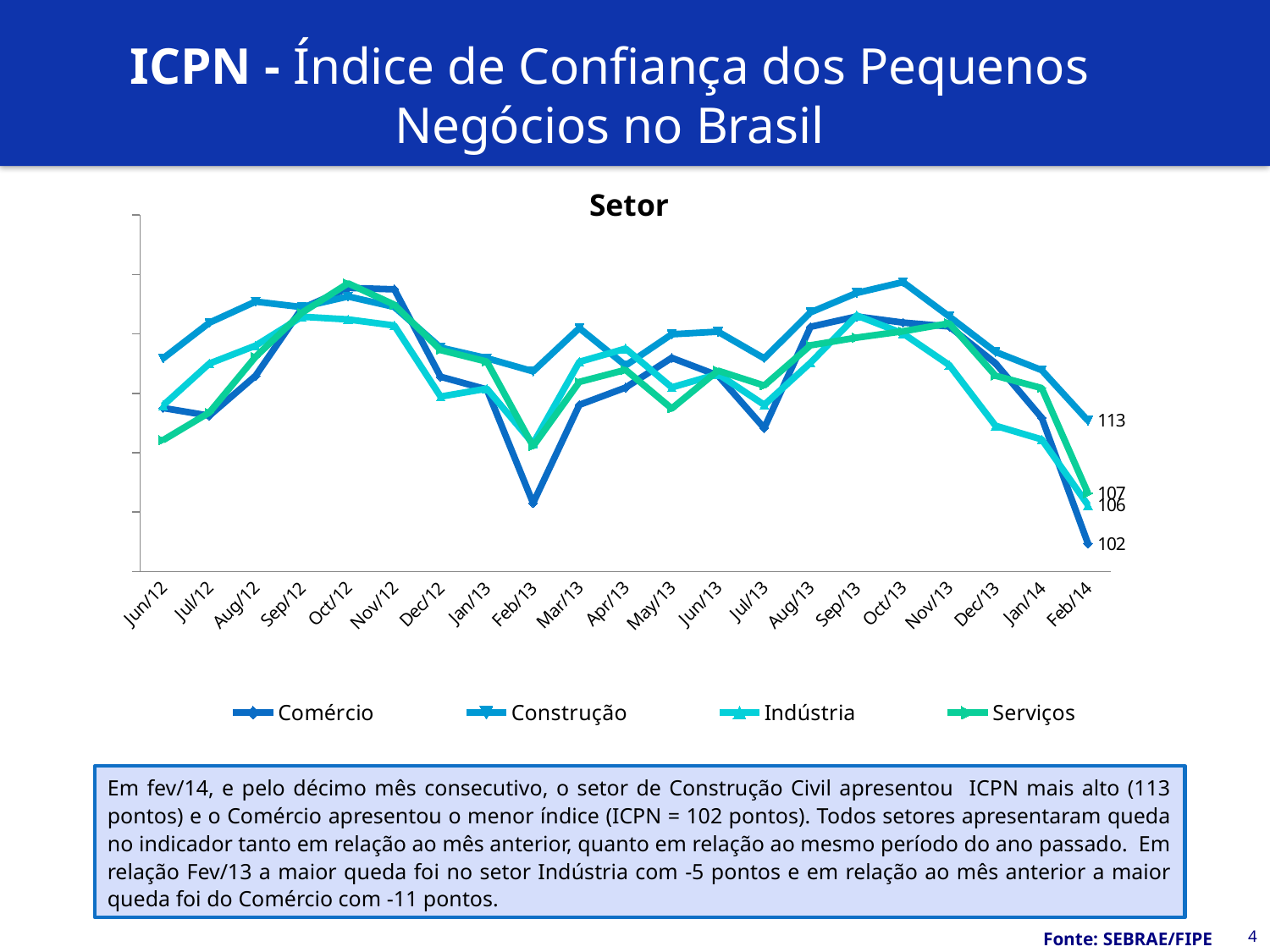
What is the value for Construção in Feb/14? 113 How many series does the legend list? 4 What is the difference between the Construção and Comércio values in Feb/14? 11 What kind of chart is shown on the slide? line chart What is the value for Indústria in Feb/14? 106 What is the value for Serviços in Feb/14? 107 What is the title of the chart? Setor How many months are plotted along the x axis? 21 Which sector has the highest value in Feb/14? Construção What is the value for Comércio in Feb/14? 102 Which sector has the lowest value in Feb/14? Comércio Do the values for Comércio rise or fall from Nov/13 to Feb/14? fall